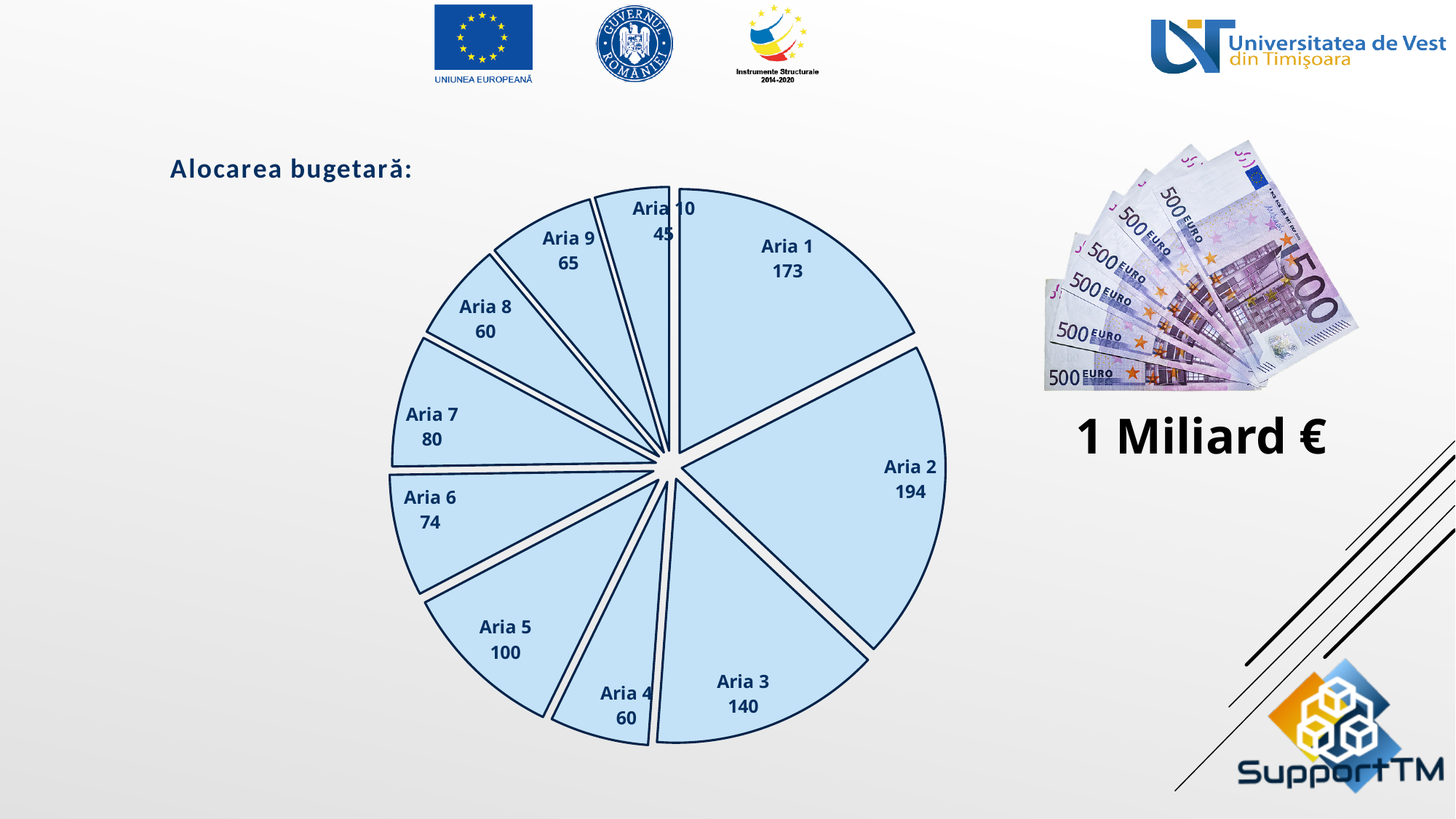
What is the value for Aria 5 in the pie chart? 100 What is the difference between the values for Aria 3 and Aria 5? 40 What is the difference between the values for Aria 2 and Aria 1? 21 What is the title text shown above the pie chart? Alocarea bugetară: What is the value for Aria 10 in the pie chart? 45 How many slices does the pie chart have? 10 Which has a larger value, Aria 7 or Aria 9? Aria 7 Which slice of the pie chart has the highest value? Aria 2 What is the value for Aria 2 in the pie chart? 194 What type of chart is shown on the slide? pie chart Which slice of the pie chart has the lowest value? Aria 10 What is the value for Aria 6 in the pie chart? 74